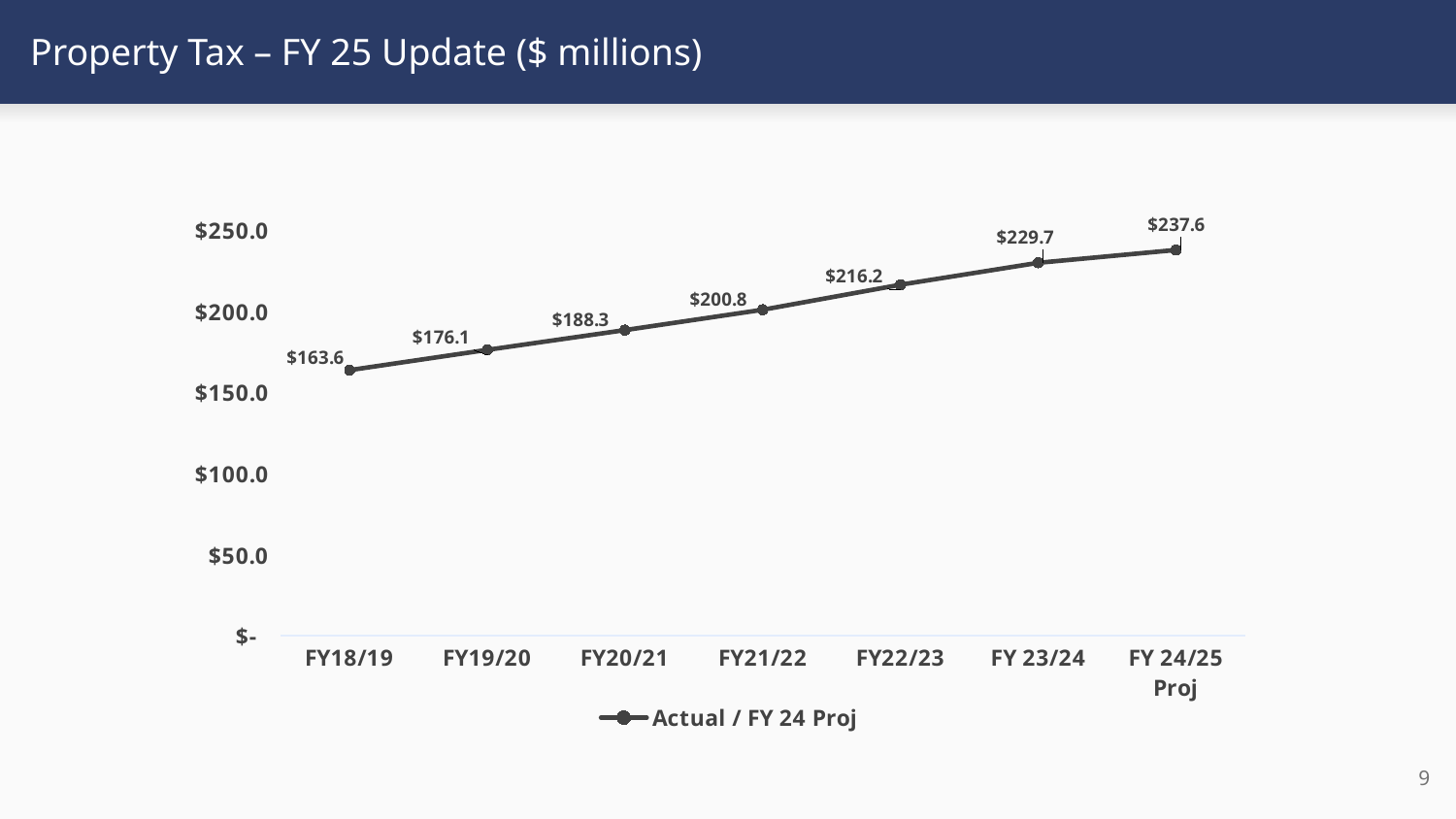
What is the value for FY21/22? $200.8 Do the values rise or fall from FY18/19 to FY 24/25 Proj? Rise What is the value for FY18/19? $163.6 What is the difference between the FY 23/24 value and the FY22/23 value? $13.5 What is the value for FY 24/25 Proj? $237.6 What kind of chart is shown on the slide? Line chart Which fiscal year has the highest value? FY 24/25 Proj Which fiscal year has the lowest value? FY18/19 Which is larger, the value for FY19/20 or the value for FY20/21? FY20/21 What is the difference between the FY 24/25 Proj value and the FY18/19 value? $74.0 Is the value for FY22/23 greater or less than $200.0? greater How many fiscal years are plotted on the chart? 7